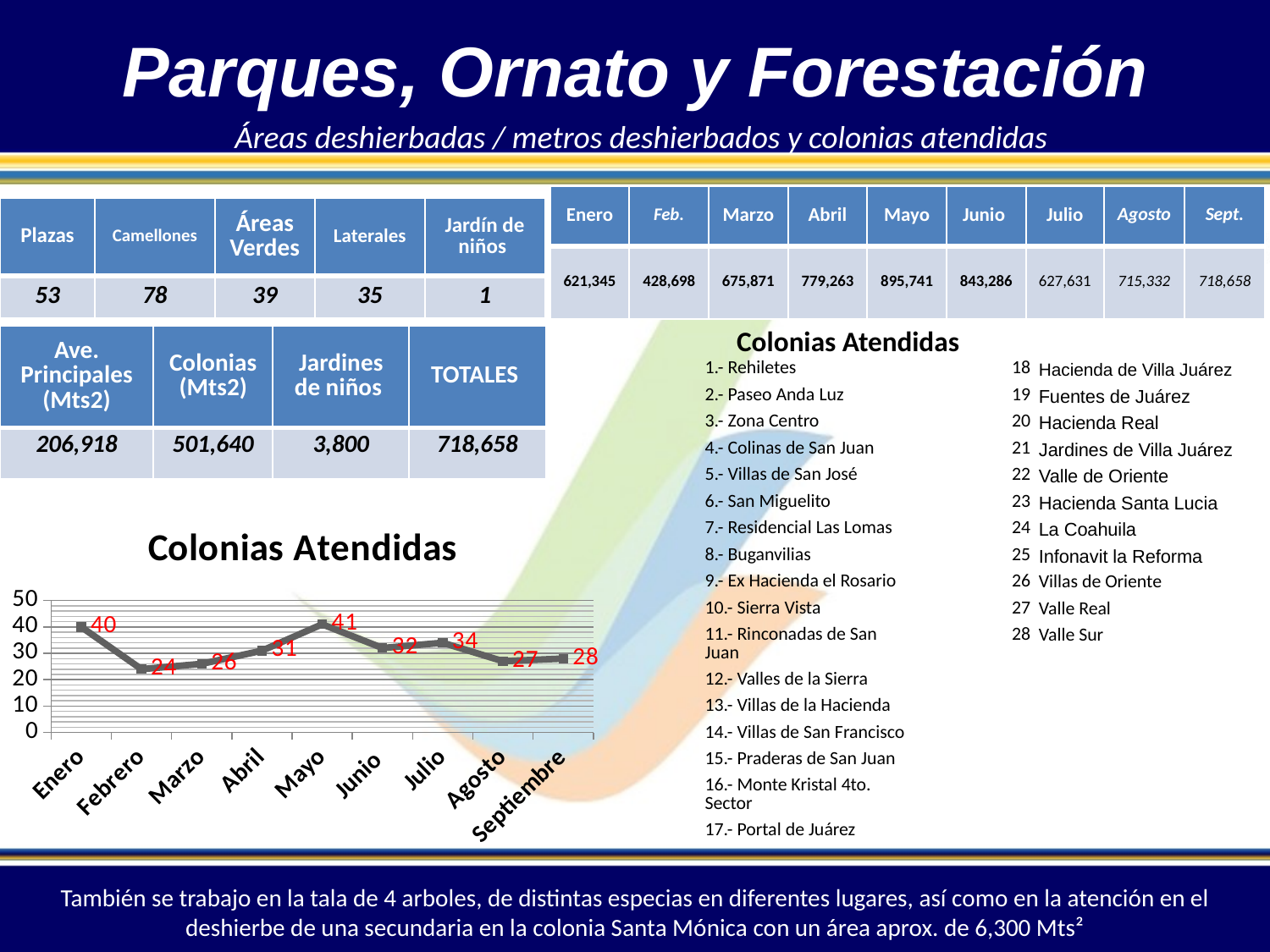
In the "Colonias Atendidas" chart, does the value rise or fall from Enero to Febrero? fall How many months are plotted in the "Colonias Atendidas" chart? 9 In the "Colonias Atendidas" chart, what is the difference between the values for Mayo and Febrero? 17 In the "Colonias Atendidas" chart, what is the value for Enero? 40 In the "Colonias Atendidas" chart, which month has the lowest value? Febrero In the "Colonias Atendidas" chart, which month has the highest value? Mayo In the "Colonias Atendidas" chart, what is the value for Septiembre? 28 In the "Colonias Atendidas" chart, which is larger, the value for Abril or the value for Junio? Junio What is the title of the line chart on the slide? Colonias Atendidas In the "Colonias Atendidas" chart, what is the value for Mayo? 41 In the "Colonias Atendidas" chart, is the value for Julio greater or less than 30? greater What type of chart is the "Colonias Atendidas" chart? line chart